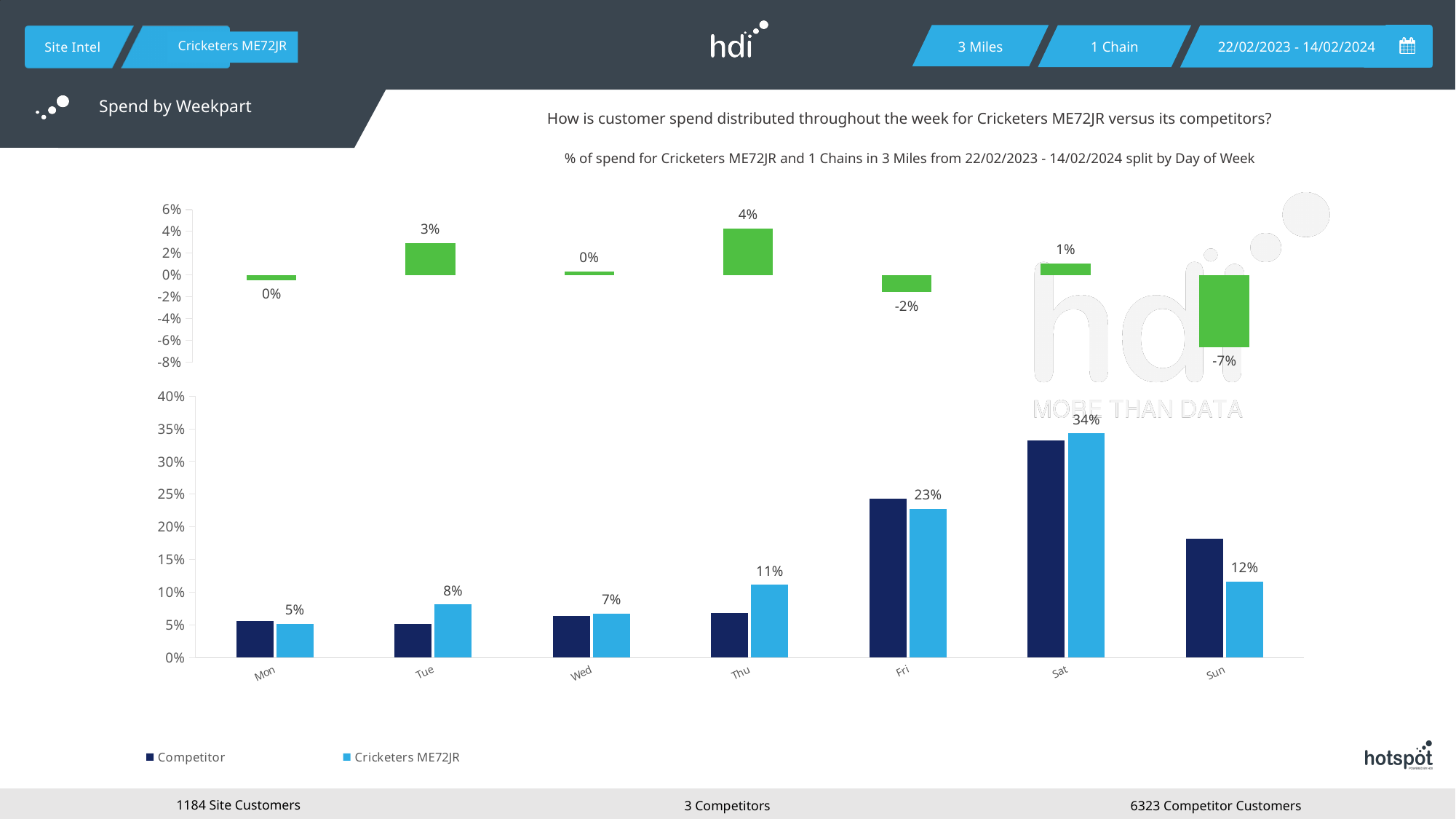
In the bottom chart, what is the difference between the Cricketers ME72JR values for Sat and Fri? 11% In the bottom chart, what is the value for Cricketers ME72JR on Thu? 11% In the bottom chart, which is larger on Sun: the Competitor bar or the Cricketers ME72JR bar? Competitor In the bottom chart, which day has the highest value for Cricketers ME72JR? Sat In the bottom chart, what is the value for Cricketers ME72JR on Sat? 34% In the bottom chart, is the Competitor value for Sun greater or less than 15%? greater How many days are shown on the x axis of the bottom chart? 7 In the top chart, which day has the lowest value? Sun In the top chart, what is the value for Thu? 4% How many series does the legend of the bottom chart list? 2 In the bottom chart, which day has the lowest value for Cricketers ME72JR? Mon In the top chart, what is the value for Sun? -7%